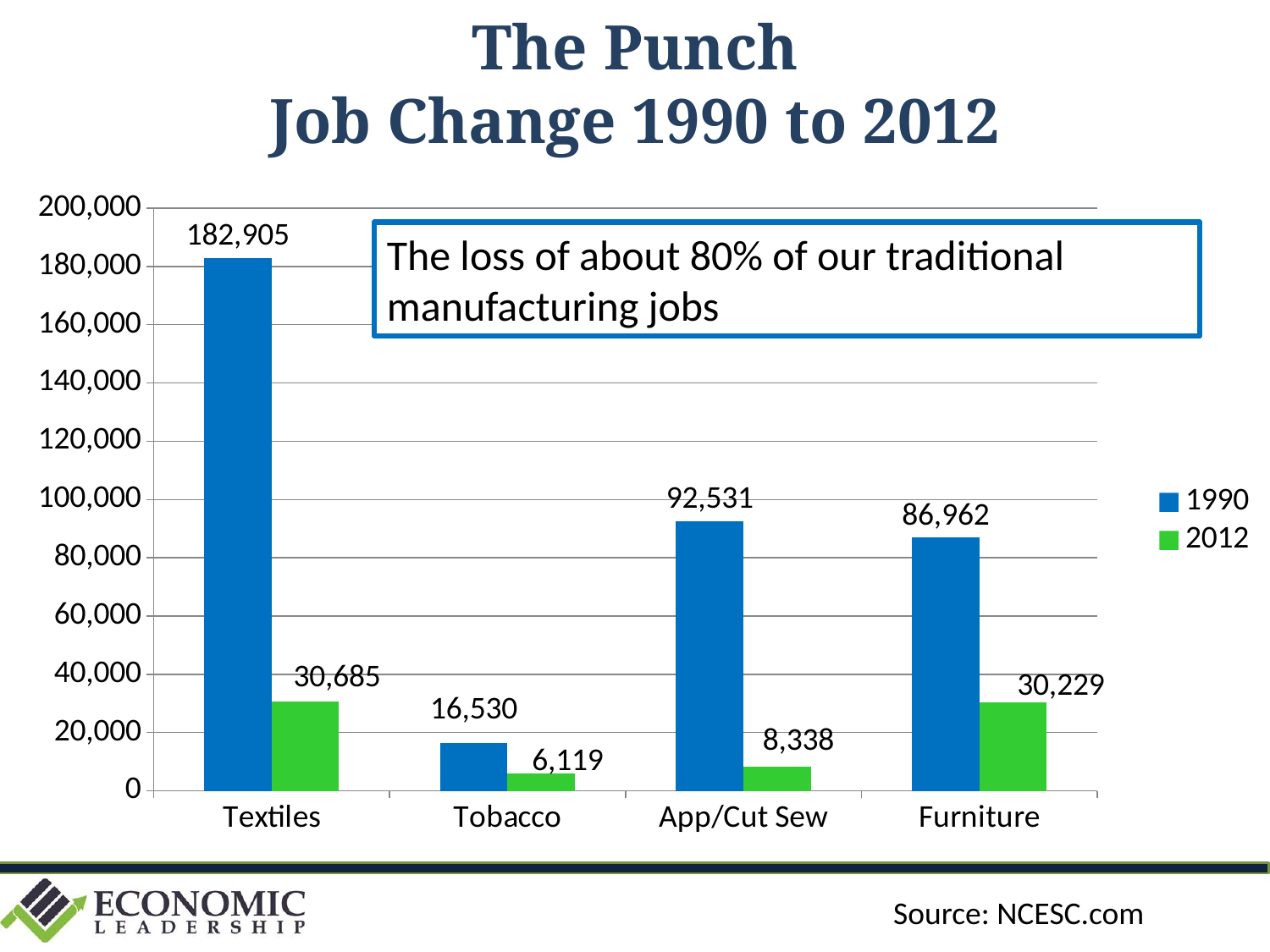
How many categories are shown on the x axis? 4 How many series does the legend list? 2 Is the 1990 value for Tobacco greater or less than 20,000? less What is the difference between the 1990 and 2012 values for App/Cut Sew? 84,193 What was the 1990 value for Textiles? 182,905 Which is larger, the 1990 value for App/Cut Sew or the 1990 value for Furniture? App/Cut Sew Which category had the lowest 2012 value? Tobacco Which colour represents the 2012 series? green What was the 2012 value for Furniture? 30,229 What was the 2012 value for Tobacco? 6,119 What kind of chart is shown on the slide? bar chart Which category had the highest 1990 value? Textiles